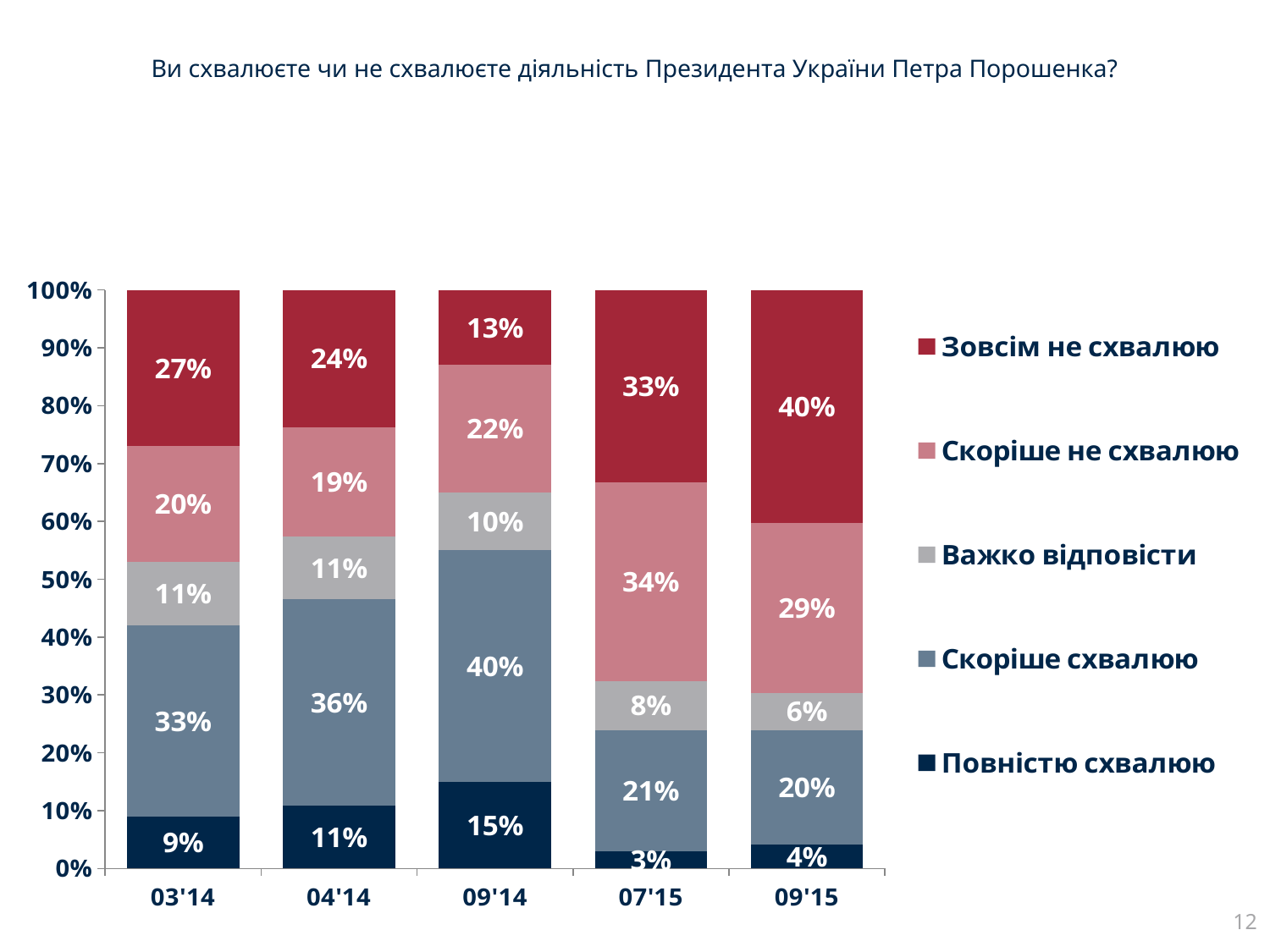
What is the value for "Важко відповісти" in 07'15? 8% How many time periods are shown on the x axis? 5 What kind of chart is shown on the slide? Stacked bar chart Does the "Зовсім не схвалюю" share rise or fall from 09'14 to 09'15? Rises Which period has the larger "Скоріше не схвалюю" share, 07'15 or 09'15? 07'15 How many series does the legend list? 5 What is the value for "Зовсім не схвалюю" in 09'15? 40% What is the value for "Повністю схвалюю" in 09'14? 15% What is the combined share of "Повністю схвалюю" and "Скоріше схвалюю" in 04'14? 47% By how many percentage points does "Зовсім не схвалюю" in 09'15 exceed "Зовсім не схвалюю" in 03'14? 13 percentage points In which period is the "Скоріше схвалюю" share the highest? 09'14 In which period is the "Повністю схвалюю" share the lowest? 07'15